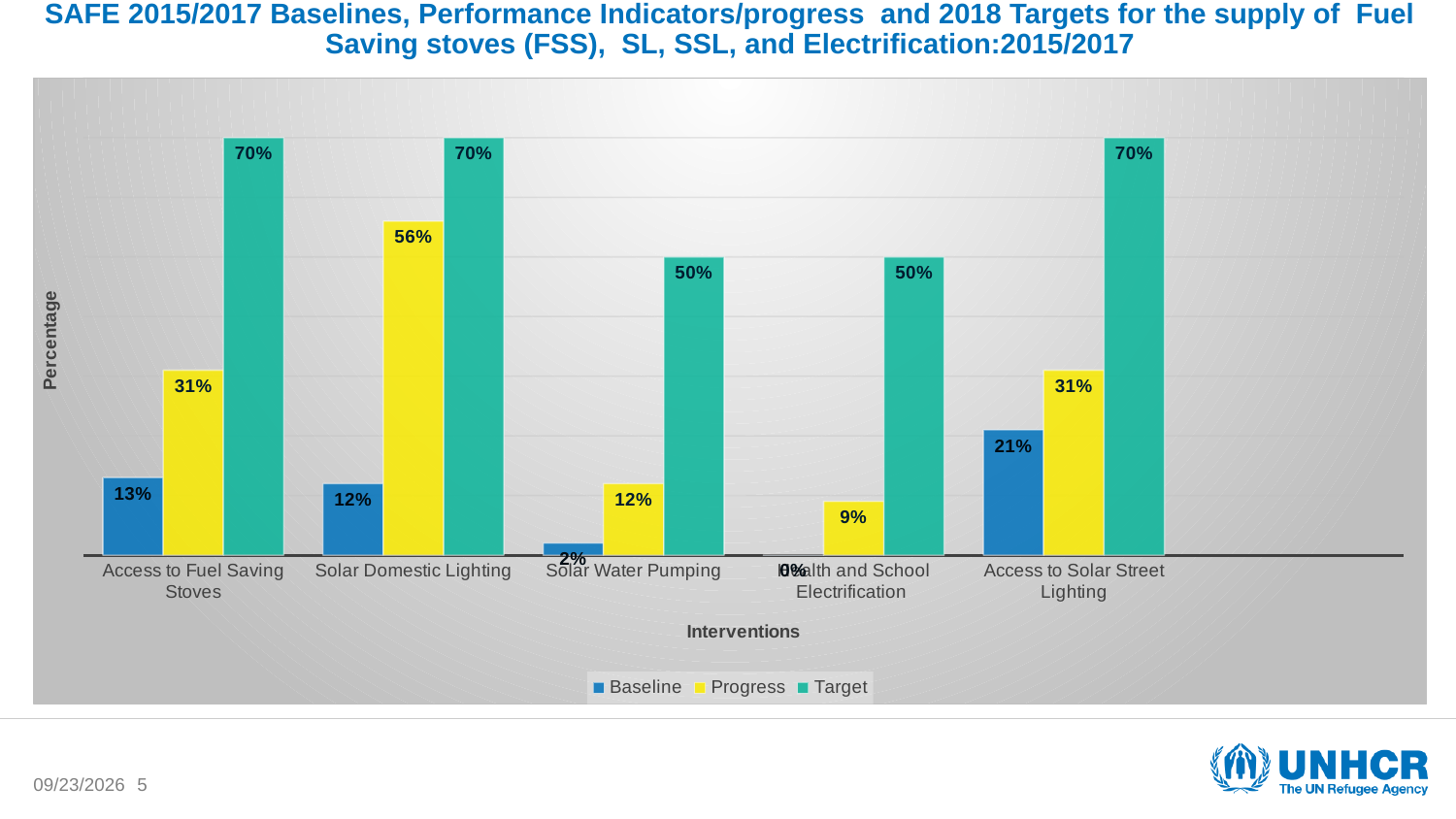
Which intervention has the lowest Baseline value? Health and School Electrification What is the difference between the Target and Progress values for Access to Fuel Saving Stoves? 39% What is the Progress value for Health and School Electrification? 9% How many interventions are shown on the x axis? 5 What is the Progress value for Solar Domestic Lighting? 56% How many series does the legend list? 3 What kind of chart is shown on the slide? Bar chart What is the Baseline value for Access to Solar Street Lighting? 21% Which intervention has the highest Progress value? Solar Domestic Lighting What is the label of the y axis? Percentage What is the Target value for Solar Water Pumping? 50% Which is larger, the Baseline value for Access to Fuel Saving Stoves or the Baseline value for Access to Solar Street Lighting? Access to Solar Street Lighting